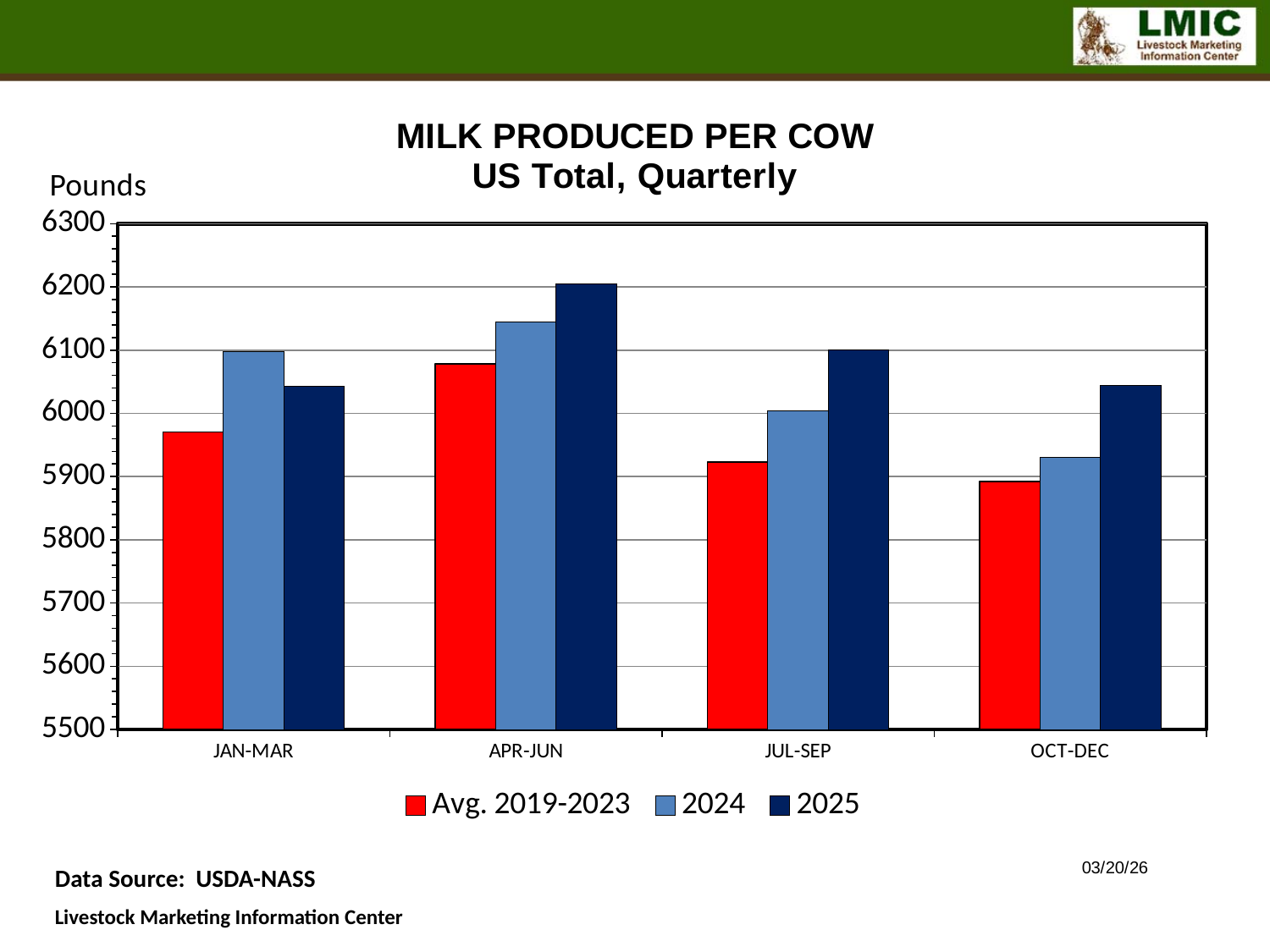
Which series and quarter has the lowest bar on the chart? Avg. 2019-2023, OCT-DEC How many quarters are shown on the x axis? 4 Within the Avg. 2019-2023 series, which quarter has the lowest value? OCT-DEC Within the 2025 series, which quarter has the highest value? APR-JUN Is the Avg. 2019-2023 value for JAN-MAR greater or less than 6000? less Which series and quarter has the highest bar on the chart? 2025, APR-JUN What unit is shown on the y axis label? Pounds Is the 2024 value for APR-JUN greater or less than 6100? greater For JUL-SEP, which is larger: the 2024 value or the 2025 value? 2025 For JAN-MAR, which is larger: the 2024 value or the 2025 value? 2024 What kind of chart is shown on the slide? bar chart How many series does the legend list? 3